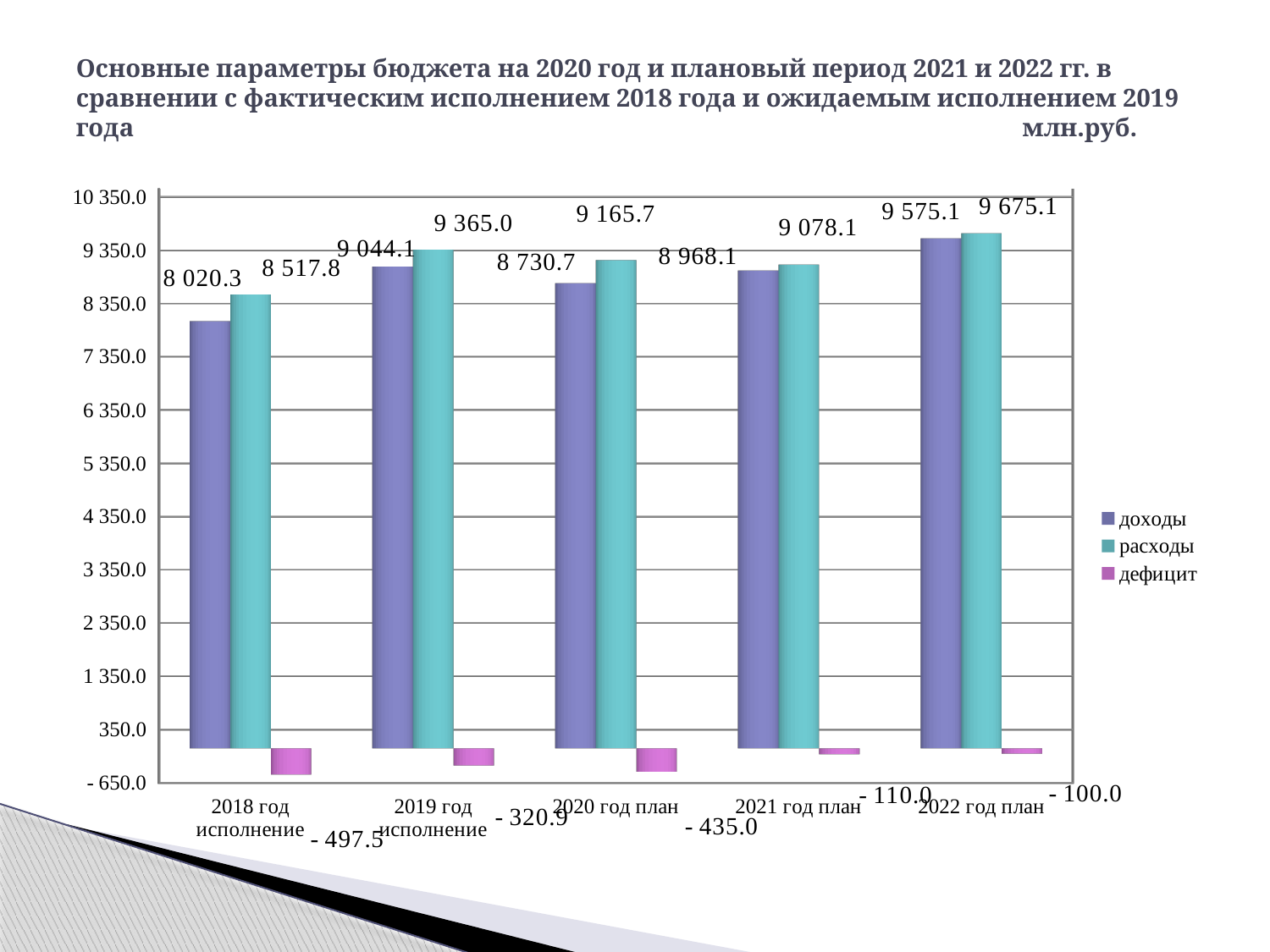
What is the value of доходы for 2018 год исполнение? 8 020.3 What kind of chart is shown on the slide? bar chart What is the difference between расходы and доходы for 2019 год исполнение? 320.9 What is the value of расходы for 2020 год план? 9 165.7 Which category has the lowest value of доходы? 2018 год исполнение What unit is stated in the chart title? млн.руб. Which category has the highest value of расходы? 2022 год план How many series does the legend list? 3 How many categories are shown on the x axis? 5 What is the value of дефицит for 2021 год план? - 110.0 Does the value of дефицит for 2022 год план lie above or below the 350.0 axis line? below Which is larger: доходы for 2020 год план or доходы for 2021 год план? доходы for 2021 год план